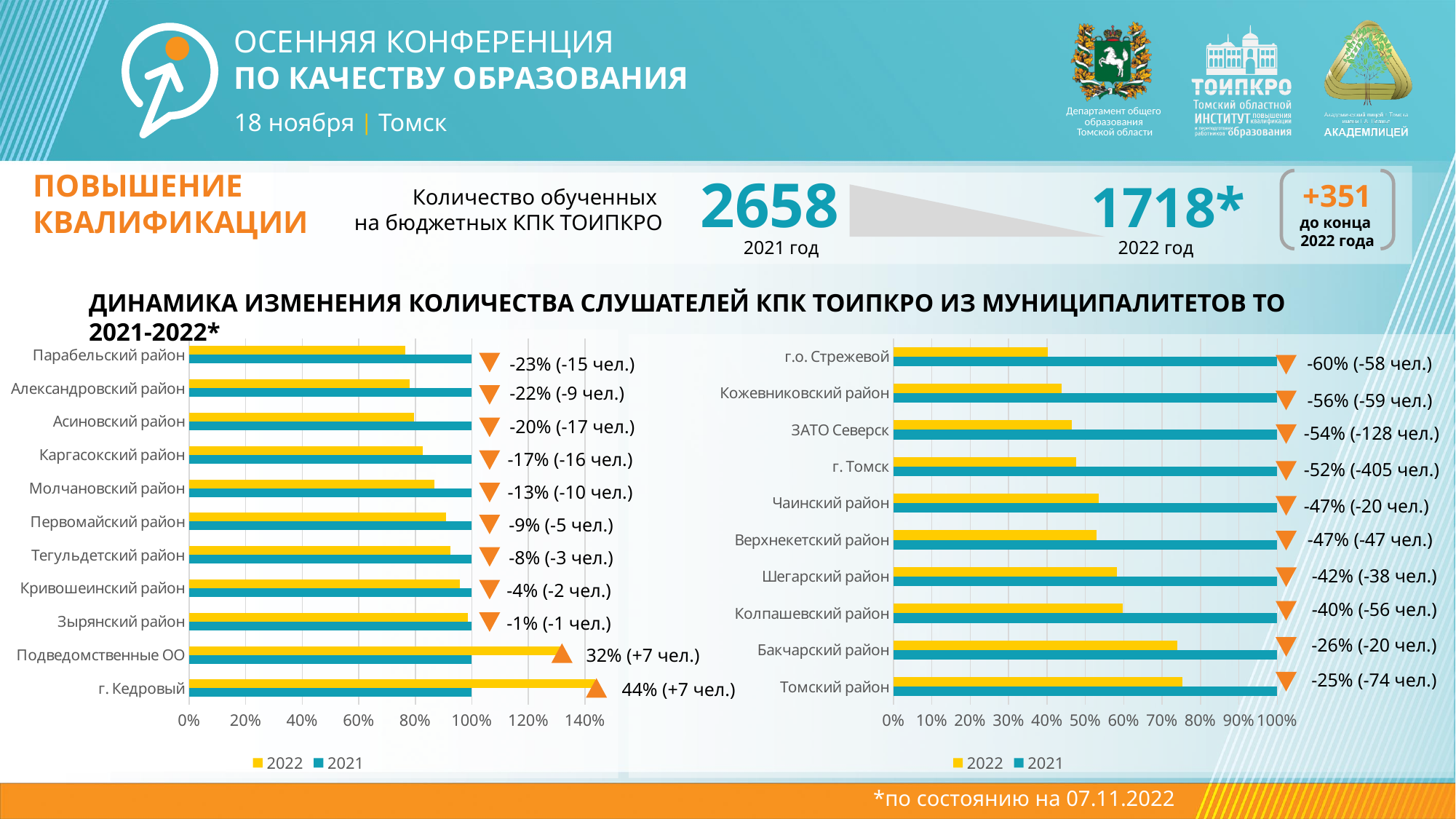
In the left chart, what change is annotated next to Парабельский район? -23% (-15 чел.) In the right chart, is the 2022 value for Томский район greater or less than 70%? greater What kind of chart is used on the left side of the slide for the municipalities starting with Парабельский район? bar chart In the left chart, which municipality has the highest 2022 bar? г. Кедровый How many series does the legend of the left chart list? 2 In the right chart (starting with г.о. Стрежевой), how many municipalities are listed? 10 In the right chart, what change is annotated next to г. Томск? -52% (-405 чел.) In the left chart (starting with Парабельский район), how many municipalities are listed? 11 What are the two legend entries of the right chart? 2022 and 2021 In the left chart, is the 2022 value for Подведомственные ОО greater or less than 120%? greater In the right chart, what change is annotated next to ЗАТО Северск? -54% (-128 чел.) In the right chart, which has the larger 2022 bar: Чаинский район or Колпашевский район? Колпашевский район